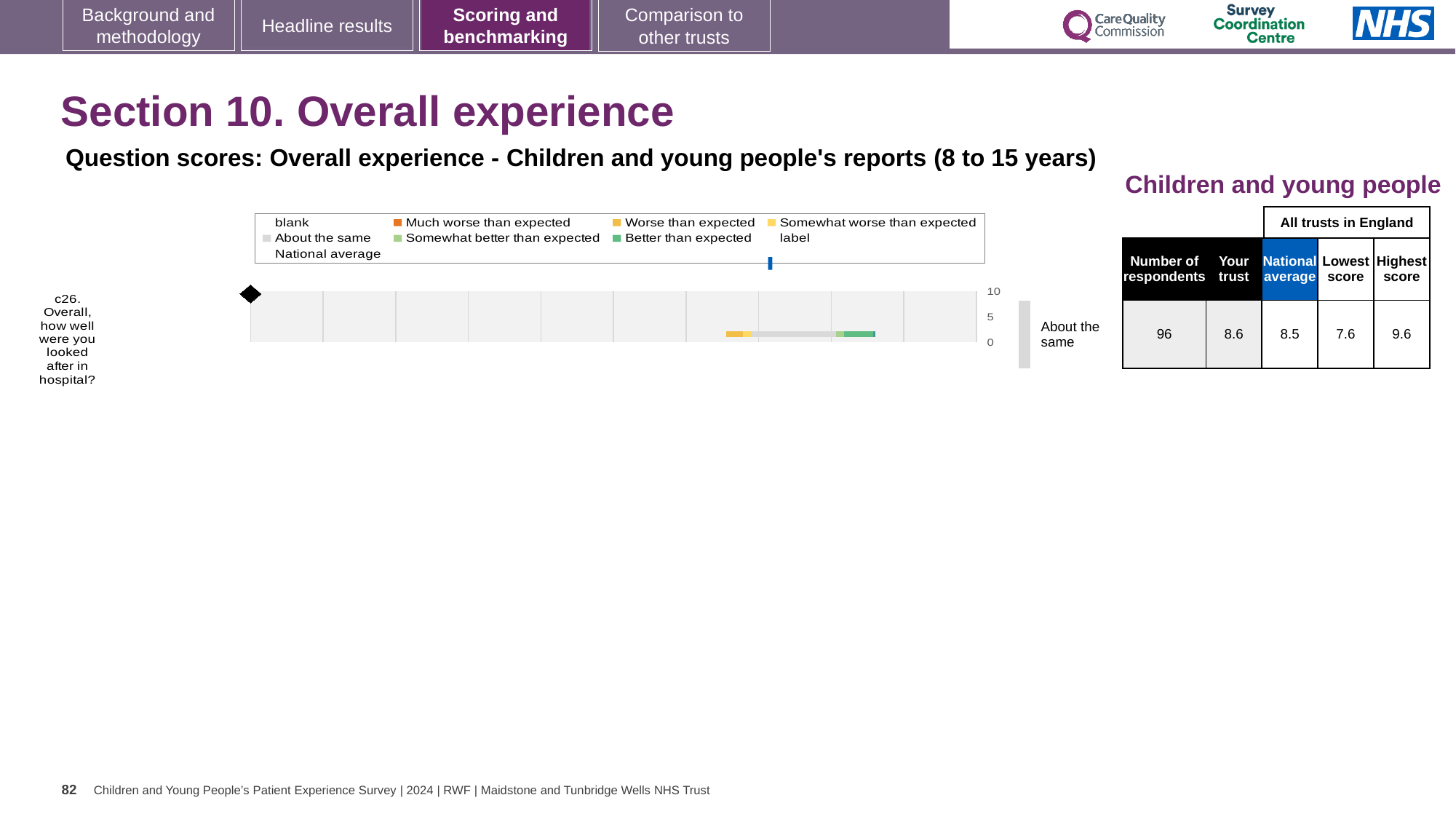
How many questions are plotted in the chart? 1 What is the maximum value shown on the chart's score axis? 10 What is the difference between the highest and lowest scores for question c26? 2.0 What is the 'Your trust' score for question c26 shown on the slide? 8.6 What is the national average score for question c26 shown on the slide? 8.5 How many respondents answered question c26? 96 Is the trust score for question c26 greater or less than 5 on the chart axis? greater What kind of chart is used to show the question score for c26? bar chart What benchmark category is shown next to the bar for question c26? About the same What is the lowest score among all trusts in England for question c26? 7.6 What is the highest score among all trusts in England for question c26? 9.6 Which is larger for question c26, the trust score or the national average? the trust score